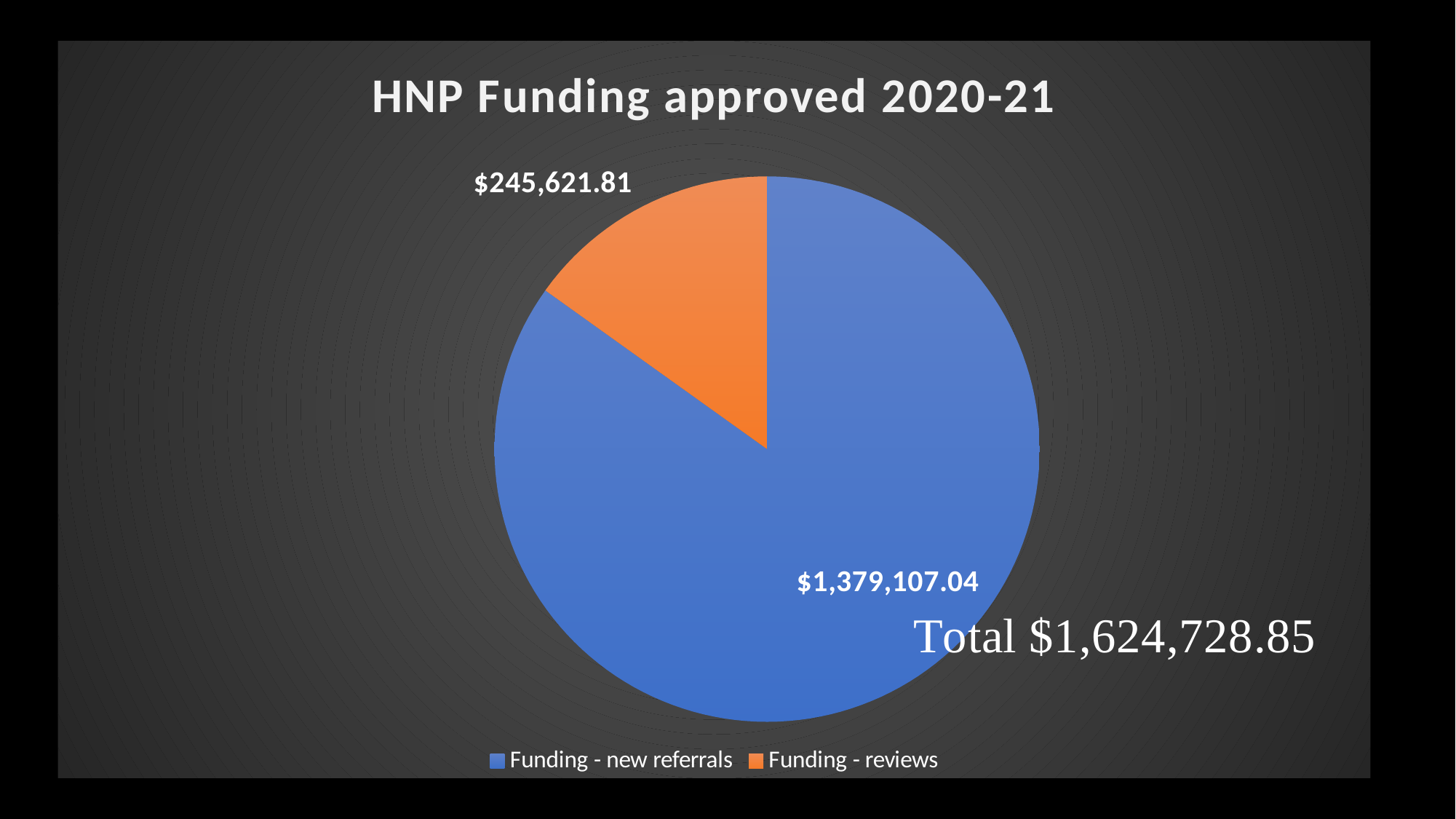
Which colour represents Funding - reviews in the pie chart? orange How many series does the legend list? 2 What type of chart is shown on the slide? pie chart What is the title of the chart? HNP Funding approved 2020-21 How many slices does the pie chart have? 2 What is the value for Funding - new referrals? $1,379,107.04 What is the difference between Funding - new referrals and Funding - reviews? $1,133,485.23 Which is larger, Funding - new referrals or Funding - reviews? Funding - new referrals What is the value for Funding - reviews? $245,621.81 Which category has the smallest slice of the pie? Funding - reviews Which category has the largest slice of the pie? Funding - new referrals What total funding amount is printed on the slide? $1,624,728.85